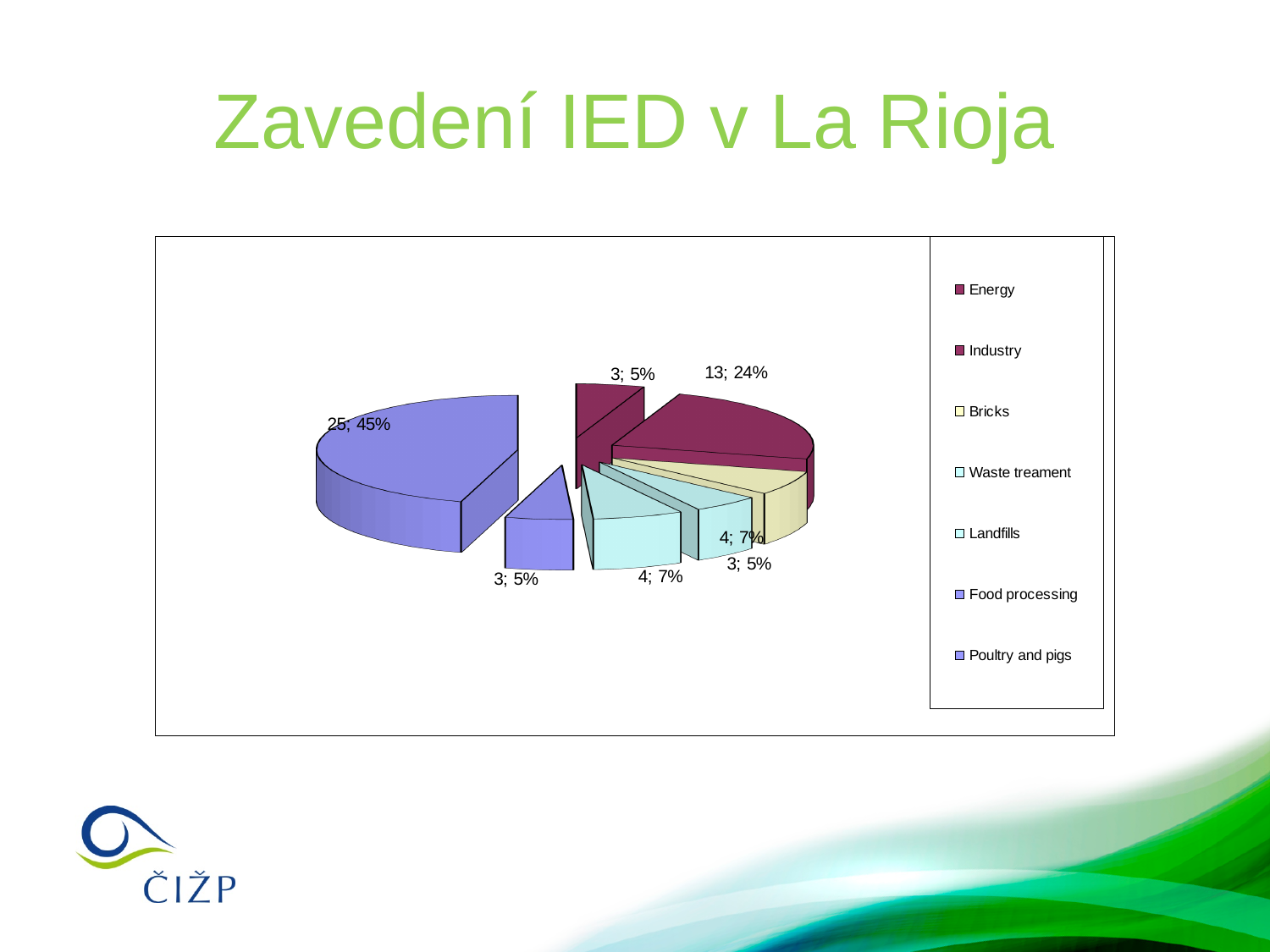
Which category has the largest slice in the pie chart? Poultry and pigs How many slices does the pie chart have? 7 What is the difference between the counts for Poultry and pigs and Industry? 12 Which legend entry is listed first in the pie chart's legend? Energy What share of the pie does Poultry and pigs represent? 45% What is the count shown for Industry? 13 How many categories does the legend of the pie chart list? 7 Which is larger, the slice for Industry or the slice for Poultry and pigs? Poultry and pigs What share of the pie does Industry represent? 24% What share of the pie does Landfills represent? 7% What is the count shown for Poultry and pigs? 25 What kind of chart is shown on the slide? Pie chart